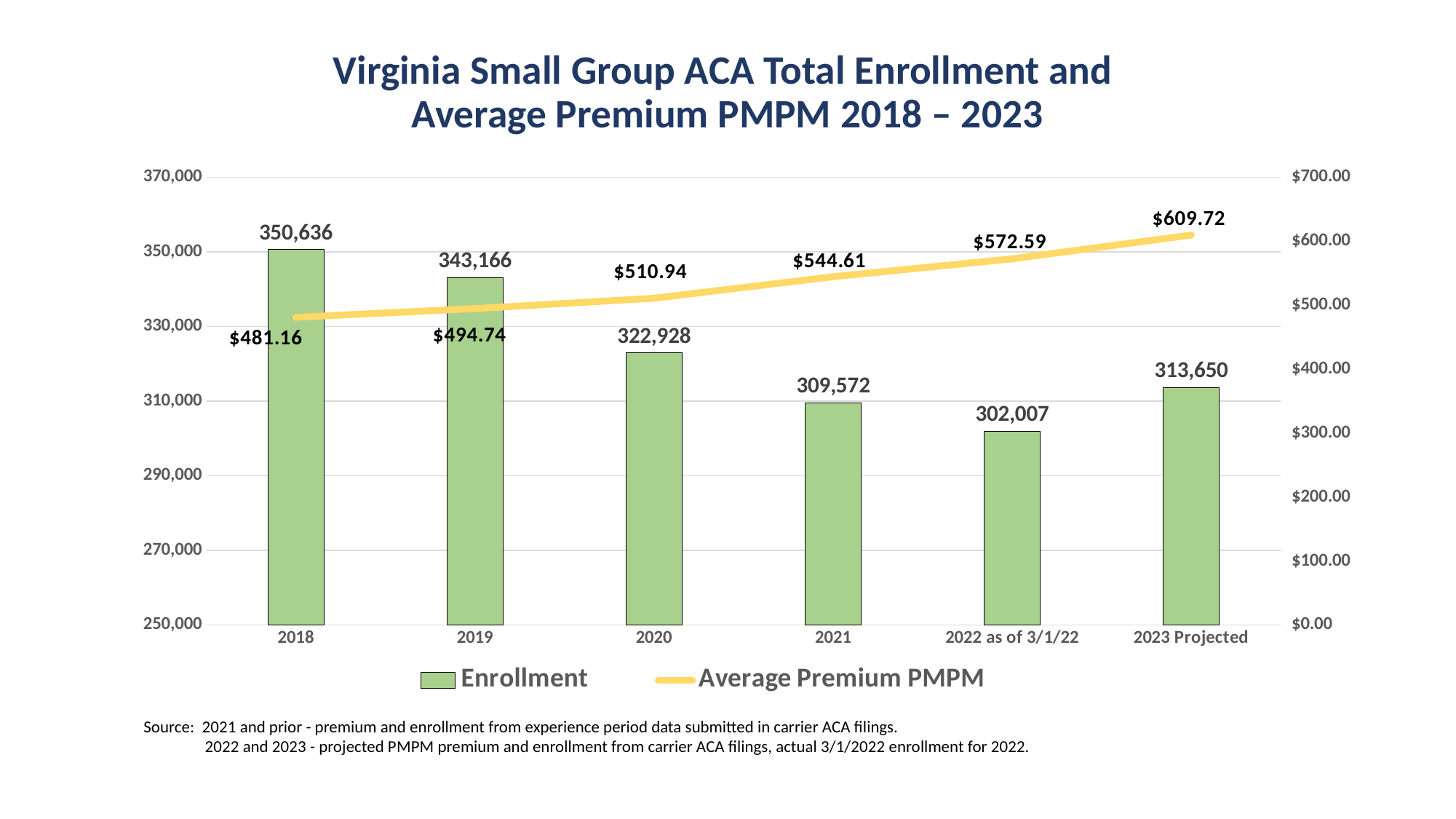
What is the difference in Average Premium PMPM between 2023 Projected and 2022 as of 3/1/22? $37.13 What is the Enrollment value for 2022 as of 3/1/22? 302,007 What is the Enrollment value for 2018? 350,636 Which is larger, the Enrollment for 2020 or for 2023 Projected? 2020 What is the Average Premium PMPM for 2023 Projected? $609.72 What is the difference in Enrollment between 2018 and 2019? 7,470 How many series does the legend list? 2 How many categories are shown on the x axis? 6 Which year has the highest Enrollment? 2018 Which year has the lowest Enrollment? 2022 as of 3/1/22 What is the Average Premium PMPM for 2021? $544.61 Does the Average Premium PMPM rise or fall from 2018 to 2023 Projected? rise